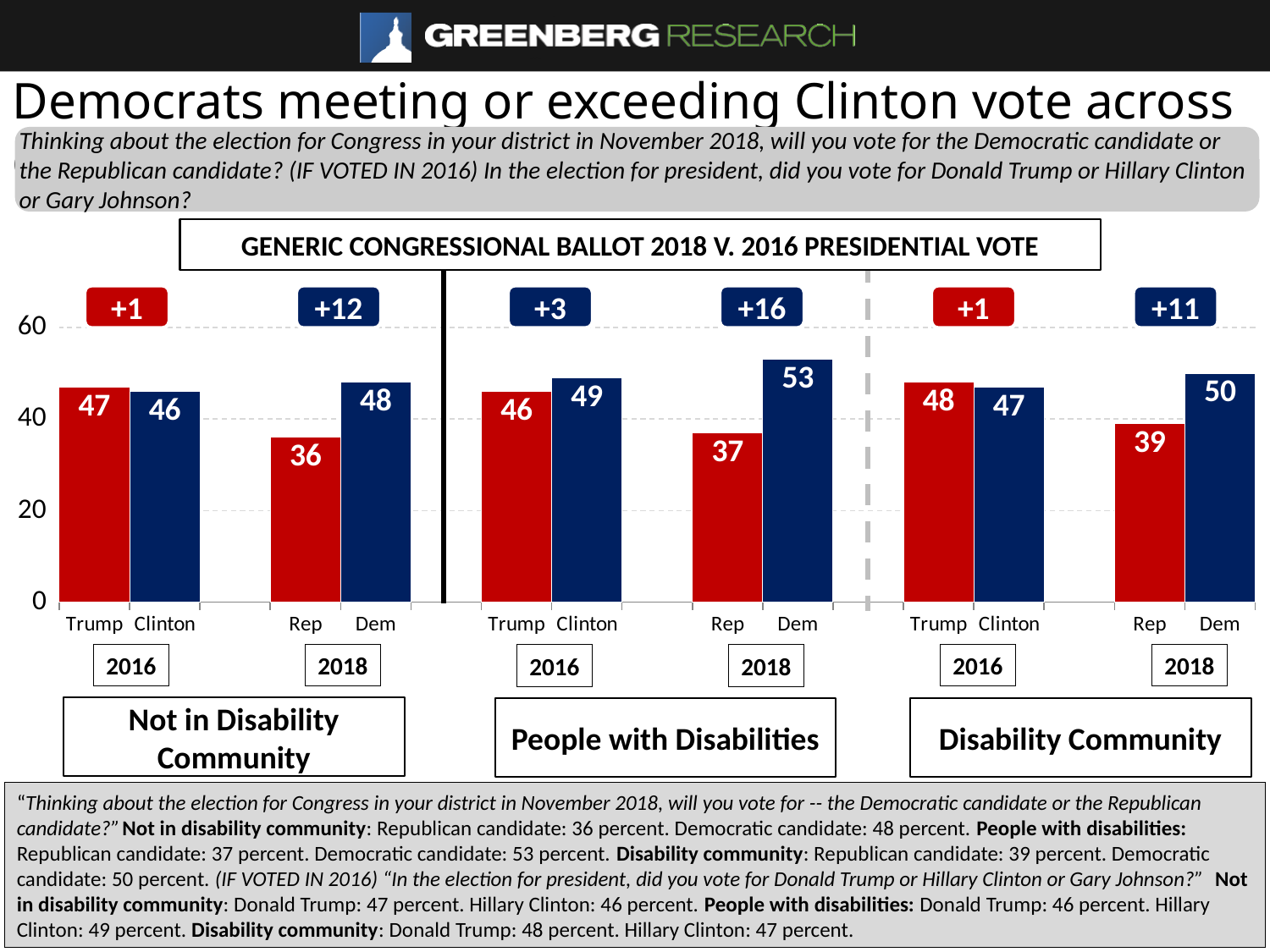
Across all three panels, which bar has the highest value? Dem 2018 in People with Disabilities (53) In the Disability Community panel, what is the difference between the Dem 2018 value and the Rep 2018 value? 11 In the Disability Community panel, what value is shown for Rep in 2018? 39 In the People with Disabilities panel, what value is shown for Clinton in 2016? 49 Across all three panels, which bar has the lowest value? Rep 2018 in Not in Disability Community (36) What type of chart is shown on the slide? Bar chart How many bars are plotted in total across the three panels? 12 In the People with Disabilities panel, is the value for Rep in 2018 greater or less than 40? less In the Not in Disability Community panel, which is larger: the Clinton 2016 value or the Dem 2018 value? Dem 2018 In the Not in Disability Community panel, what value is shown for Trump in 2016? 47 What is the title of the chart? GENERIC CONGRESSIONAL BALLOT 2018 V. 2016 PRESIDENTIAL VOTE In the People with Disabilities panel, what value is shown for Dem in 2018? 53